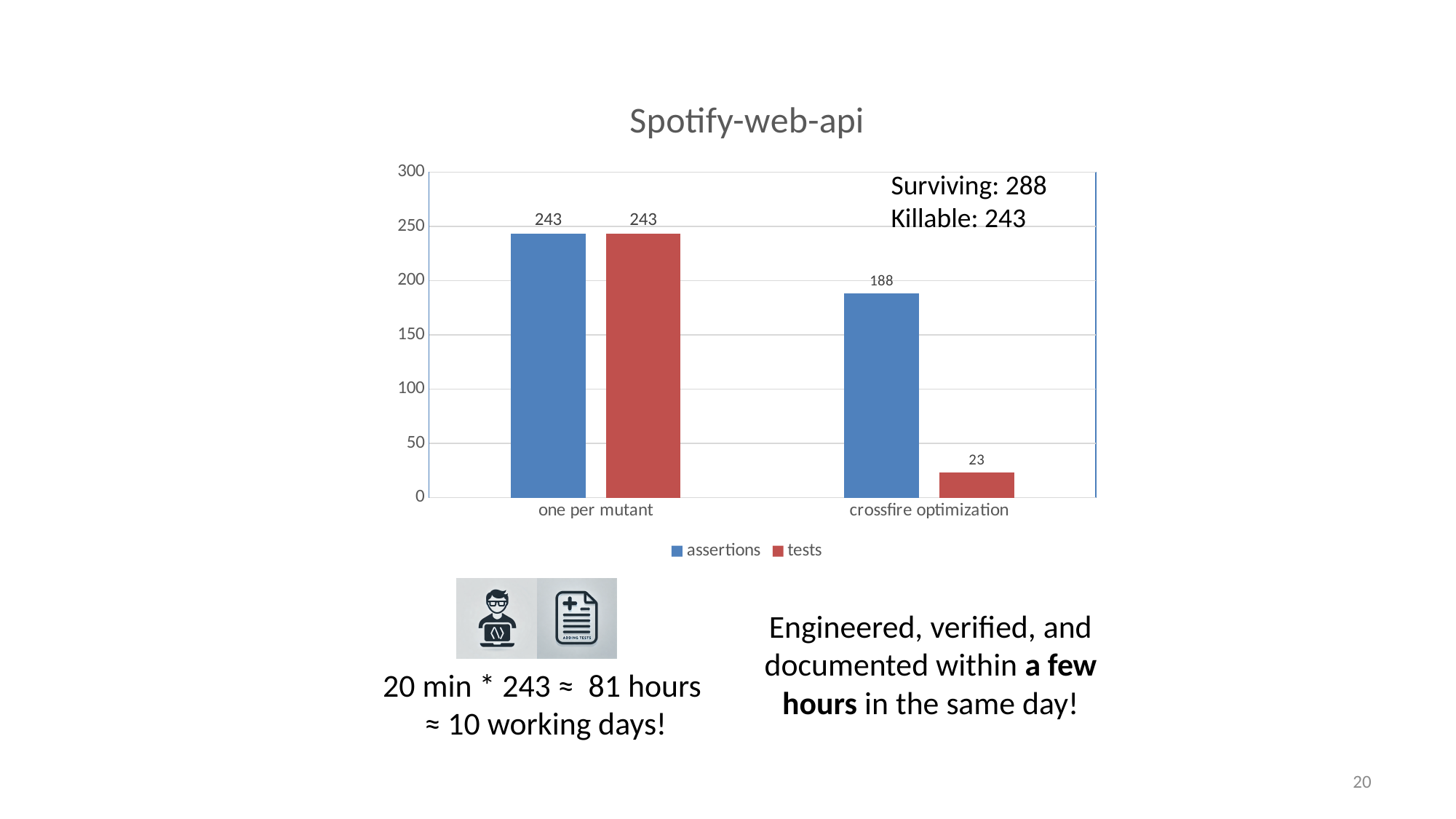
What is the value of assertions for one per mutant? 243 Which category has the highest assertions value? one per mutant What is the value of assertions for crossfire optimization? 188 What is the value of tests for one per mutant? 243 What type of chart is shown on the slide? bar chart How many categories are shown on the x axis? 2 What is the difference between the assertions values for one per mutant and crossfire optimization? 55 Which category has the lowest tests value? crossfire optimization What is the value of tests for crossfire optimization? 23 What is the difference between assertions and tests for crossfire optimization? 165 How many series does the legend list? 2 Which is larger for crossfire optimization, assertions or tests? assertions